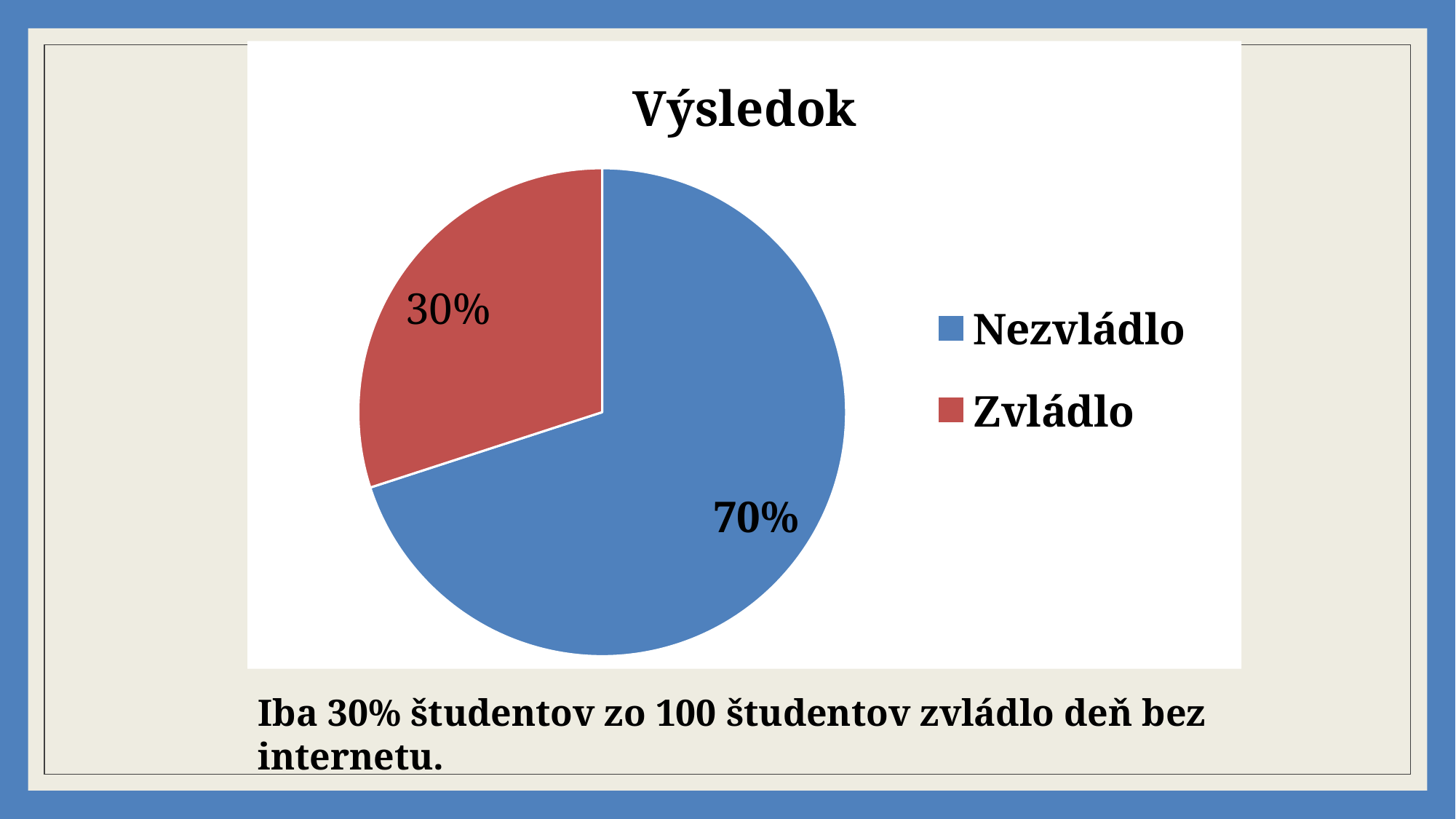
What percentage is shown for Zvládlo? 30% How many slices does the pie chart have? 2 What share of the pie does the Zvládlo slice represent? 30% What kind of chart is shown on the slide? pie chart Which is larger, the slice for Nezvládlo or the slice for Zvládlo? Nezvládlo Which category has the largest slice of the pie? Nezvládlo What percentage is shown for Nezvládlo? 70% What is the title of the chart? Výsledok How many entries does the legend list? 2 What is the difference in percentage points between Nezvládlo and Zvládlo? 40 Which category has the smallest slice of the pie? Zvládlo What colour is the Nezvládlo slice? blue